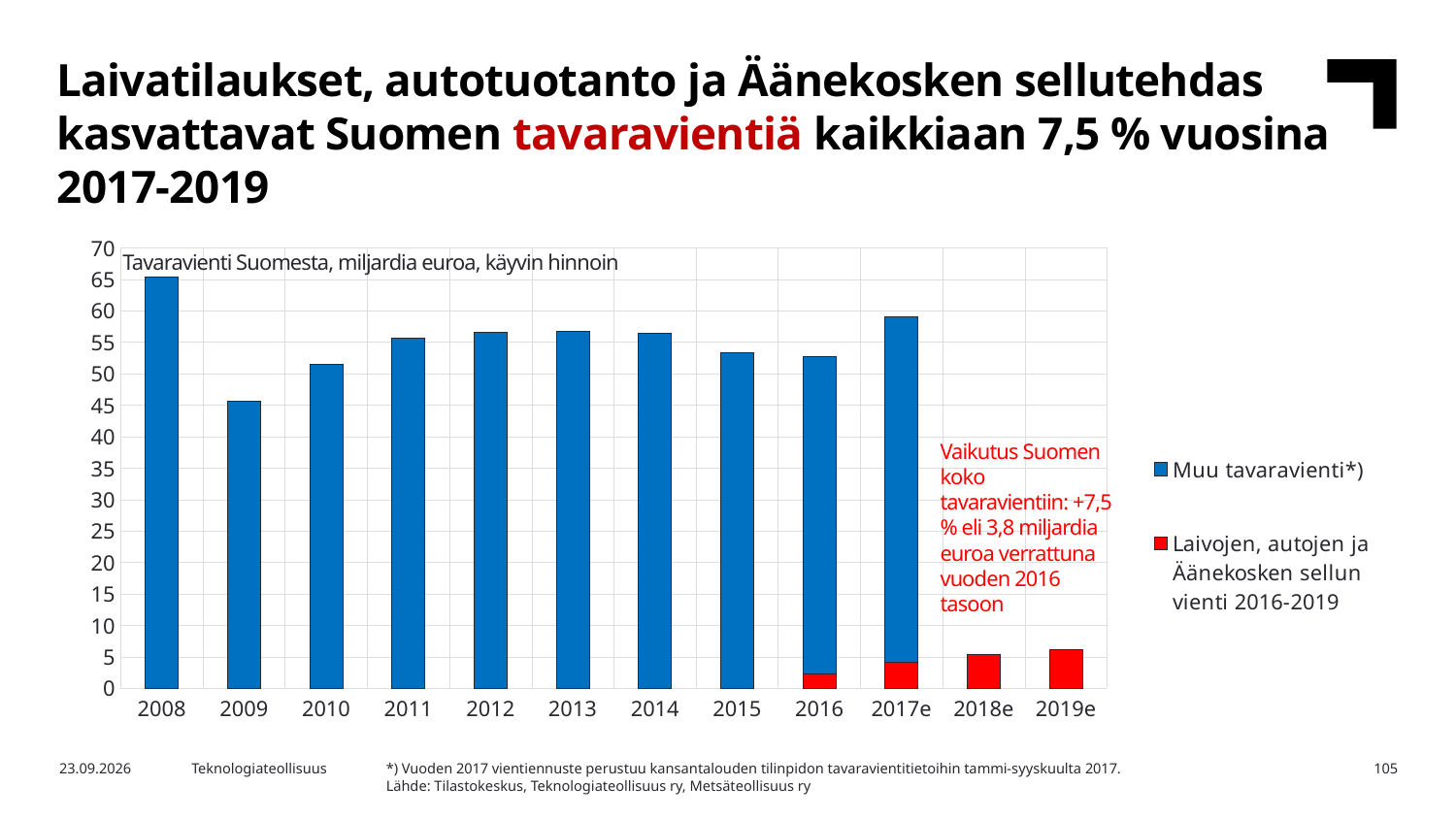
Which year has the lowest 'Muu tavaravienti*)' bar among the years 2008–2017e? 2009 Which year has the highest total bar in the chart? 2008 What kind of chart is shown on the slide? Bar chart Is the value for 2019e greater or less than 10? less Do the values rise or fall from 2008 to 2009? fall Is the value for 2010 greater or less than 50? greater How many years (categories) are shown on the x axis of the chart? 12 Which is larger, the bar for 2013 or the bar for 2015? 2013 Is the total value for 2017e greater or less than 55? greater Which is larger, the bar for 2008 or the bar for 2009? 2008 How many series does the chart legend list? 2